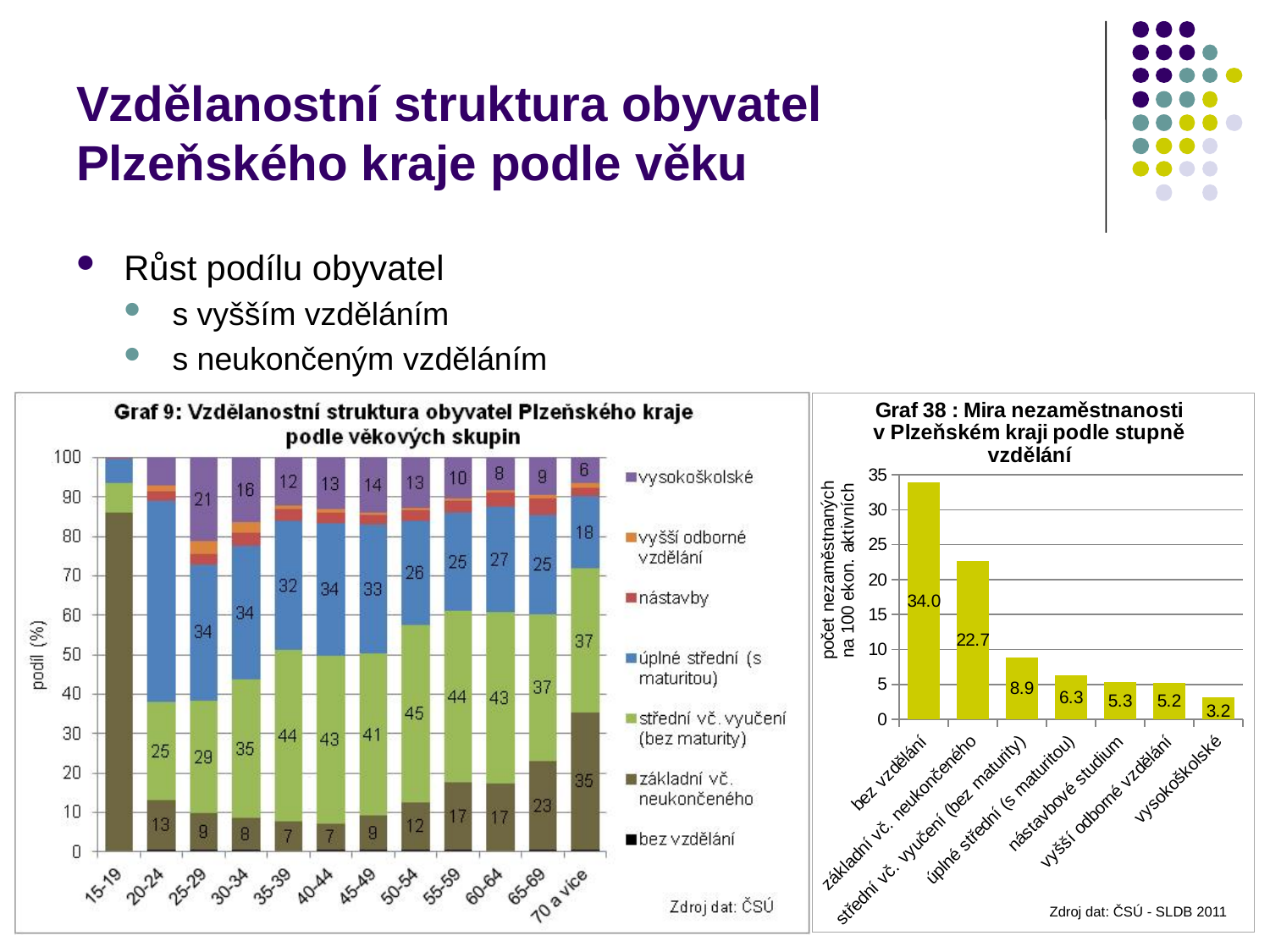
In the chart 'Graf 38', how many education categories are shown? 7 In the chart 'Graf 9', how many series does the legend list? 7 In the chart 'Graf 38', what is the value for 'bez vzdělání'? 34.0 In the chart 'Graf 38', what is the value for 'vysokoškolské'? 3.2 In the chart 'Graf 38', which education level has the highest unemployment rate? bez vzdělání In the chart 'Graf 38', which education level has the lowest unemployment rate? vysokoškolské In the chart 'Graf 9', what is the value of 'vysokoškolské' for the age group '25-29'? 21 In the chart 'Graf 38', what is the difference between the values for 'bez vzdělání' and 'základní vč. neukončeného'? 11.3 In the chart 'Graf 9', how many age groups are shown on the x axis? 12 In the chart 'Graf 9', what is the value of 'základní vč. neukončeného' for the age group '70 a více'? 35 In the chart 'Graf 38', do the values rise or fall from left to right along the x axis? fall What kind of chart is 'Graf 9'? stacked bar chart